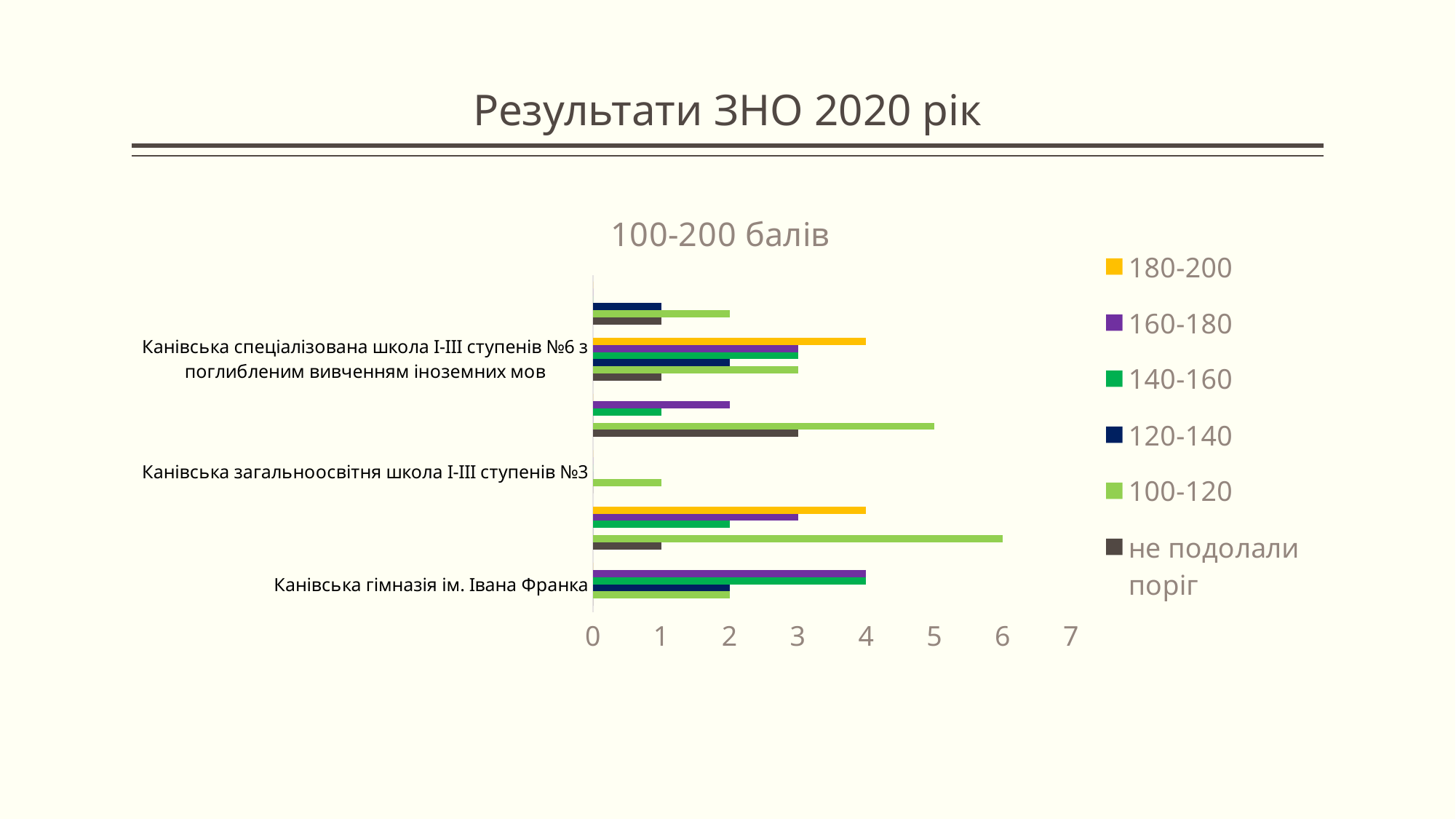
Which colour represents the 180-200 series in the legend? yellow What is the value of the 160-180 series for Канівська гімназія ім. Івана Франка? 4 How many series does the legend list? 6 What is the value of the 100-120 series for Канівська загальноосвітня школа I-III ступенів №3? 1 For Канівська спеціалізована школа I-III ступенів №6, which is larger: the 180-200 value or the 120-140 value? 180-200 What kind of chart is shown on the slide? bar chart Is the 160-180 value for Канівська гімназія ім. Івана Франка greater or less than 3? greater What is the title of the chart? 100-200 балів What is the value of the 180-200 series for Канівська спеціалізована школа I-III ступенів №6 з поглибленим вивченням іноземних мов? 4 For Канівська гімназія ім. Івана Франка, what is the difference between the 140-160 value and the 120-140 value? 2 What is the value of the 'не подолали поріг' series for Канівська спеціалізована школа I-III ступенів №6 з поглибленим вивченням іноземних мов? 1 For Канівська спеціалізована школа I-III ступенів №6, which series has the highest value? 180-200